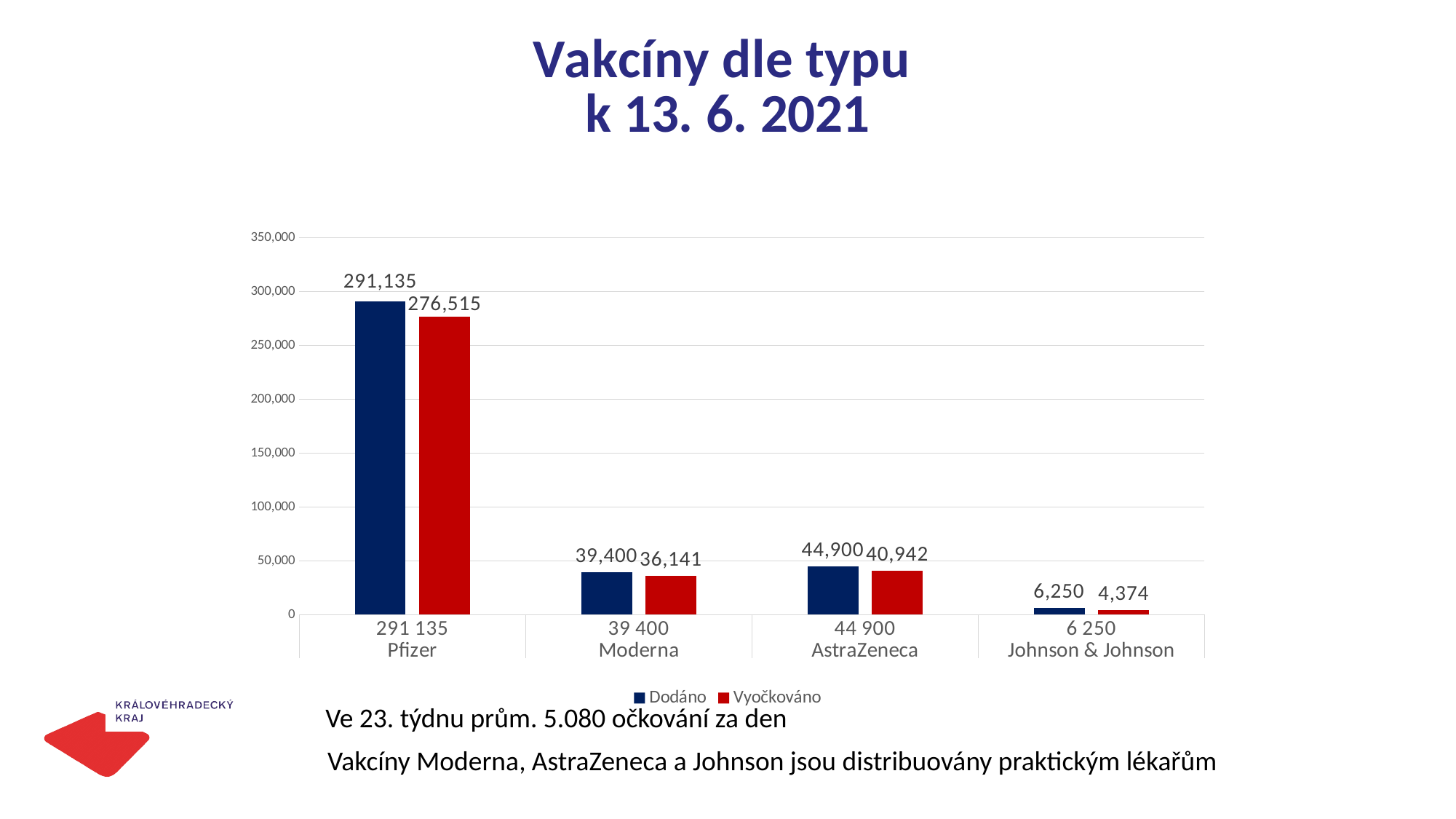
How many series does the legend list? 2 What is the Vyočkováno value for AstraZeneca? 40,942 What is the Vyočkováno value for Johnson & Johnson? 4,374 What is the difference between the Dodáno and Vyočkováno values for Pfizer? 14,620 What is the Dodáno value for Moderna? 39,400 What kind of chart is shown on the slide? Bar chart Which vaccine has the highest Dodáno value? Pfizer Which vaccine has the lowest Vyočkováno value? Johnson & Johnson How many vaccine types are shown on the x axis? 4 What is the Dodáno value for Pfizer? 291,135 Which is larger, the Vyočkováno value for AstraZeneca or for Moderna? AstraZeneca What is the difference between the Dodáno values for AstraZeneca and Moderna? 5,500